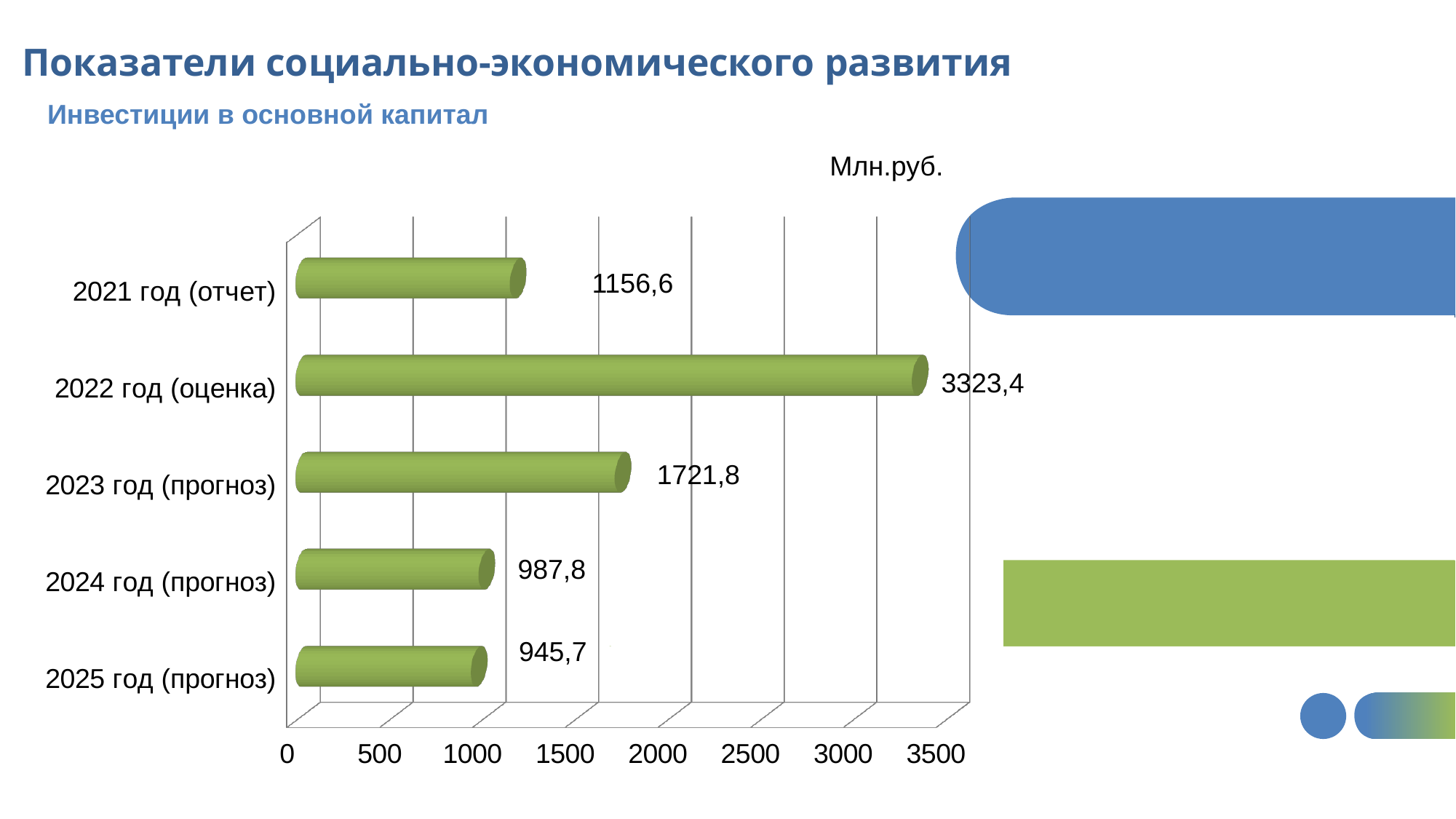
What kind of chart is shown on the slide? bar chart Which category has the lowest value? 2025 год (прогноз) Which is larger, the value for 2023 год (прогноз) or the value for 2021 год (отчет)? 2023 год (прогноз) What unit is indicated above the chart? Млн.руб. What is the difference between the values for 2023 год (прогноз) and 2024 год (прогноз)? 734 What is the value for 2024 год (прогноз)? 987,8 What is the difference between the values for 2022 год (оценка) and 2021 год (отчет)? 2166,8 What is the value for 2025 год (прогноз)? 945,7 What is the value for 2021 год (отчет)? 1156,6 Which category has the highest value? 2022 год (оценка) What is the value for 2022 год (оценка)? 3323,4 How many categories are shown in the chart? 5